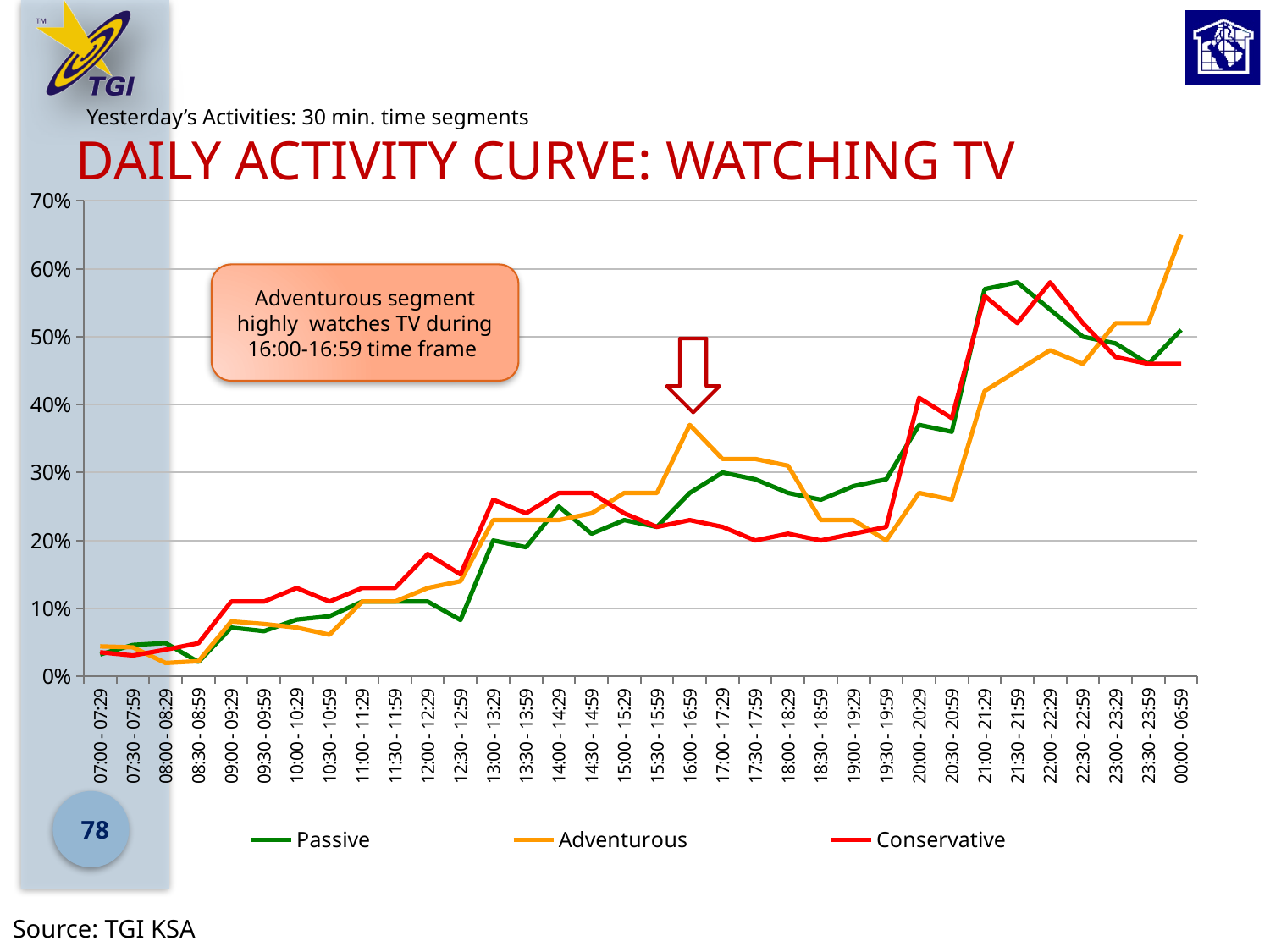
How many time segments are shown on the x axis? 34 Which series has the highest value at 00:00 - 06:59? Adventurous Is the value for Conservative at 22:00 - 22:29 greater or less than 50%? greater Is the value for Passive at 12:30 - 12:59 greater or less than 10%? less How many series does the legend list? 3 At 22:00 - 22:29, which series has the larger value, Conservative or Adventurous? Conservative Which colour represents the Conservative series in the legend? Red At 16:00 - 16:59, which series has the larger value, Adventurous or Passive? Adventurous Do the values generally rise or fall from 07:00 - 07:29 to 00:00 - 06:59? Rise Is the value for Adventurous at 00:00 - 06:59 greater or less than 60%? greater What kind of chart is shown on the slide? Line chart